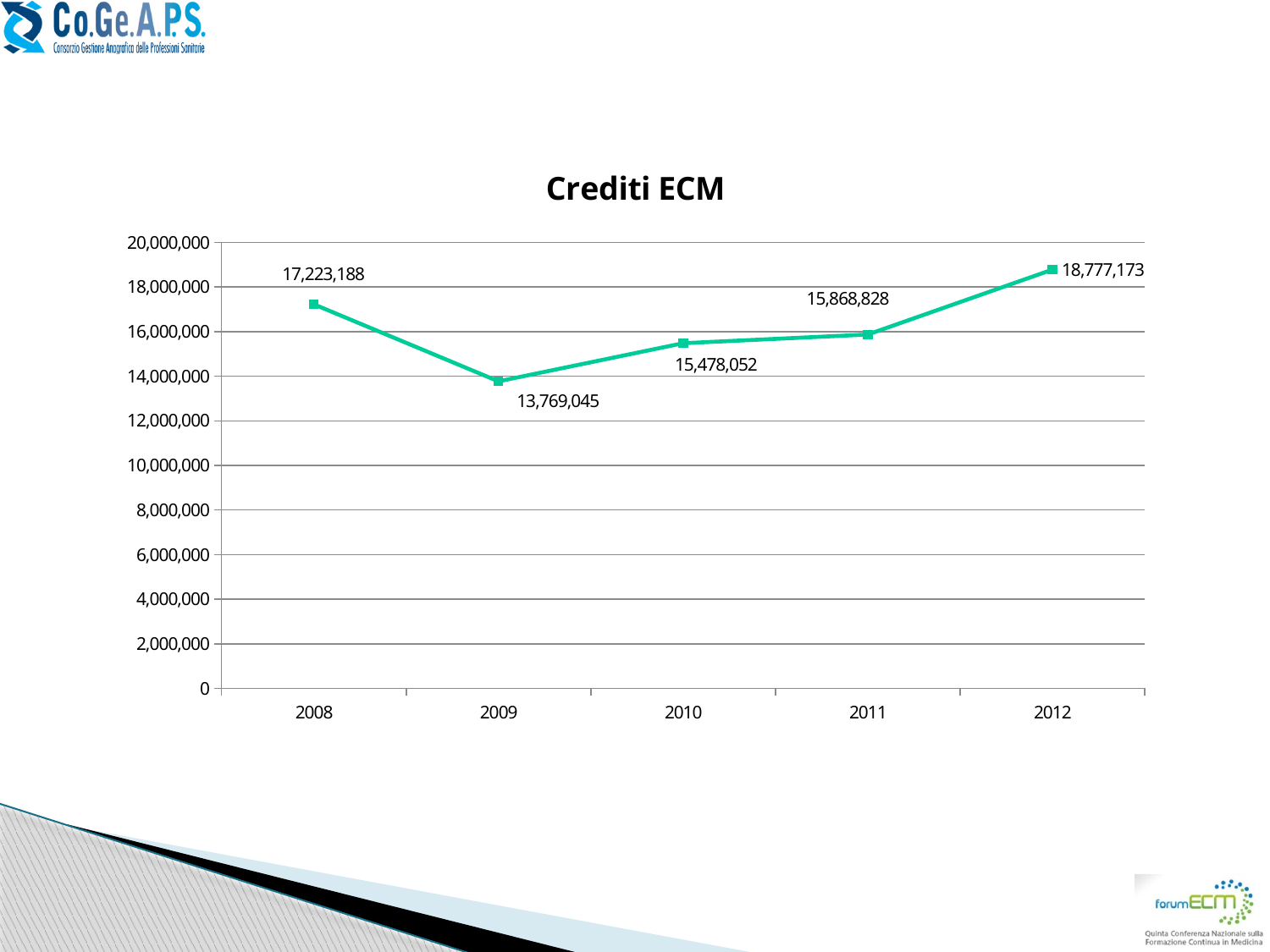
What is the value for 2008 in the Crediti ECM chart? 17,223,188 Which is larger in the Crediti ECM chart, the value for 2011 or the value for 2010? 2011 Do the values in the Crediti ECM chart rise or fall from 2009 to 2012? rise What kind of chart is the Crediti ECM chart? line chart What is the difference between the 2010 and 2009 values in the Crediti ECM chart? 1,709,007 Which year has the lowest value in the Crediti ECM chart? 2009 Is the value for 2009 in the Crediti ECM chart greater or less than 14,000,000? less How many years are plotted in the Crediti ECM chart? 5 What is the value for 2009 in the Crediti ECM chart? 13,769,045 What is the value for 2012 in the Crediti ECM chart? 18,777,173 Which year has the highest value in the Crediti ECM chart? 2012 What is the difference between the 2012 and 2008 values in the Crediti ECM chart? 1,553,985